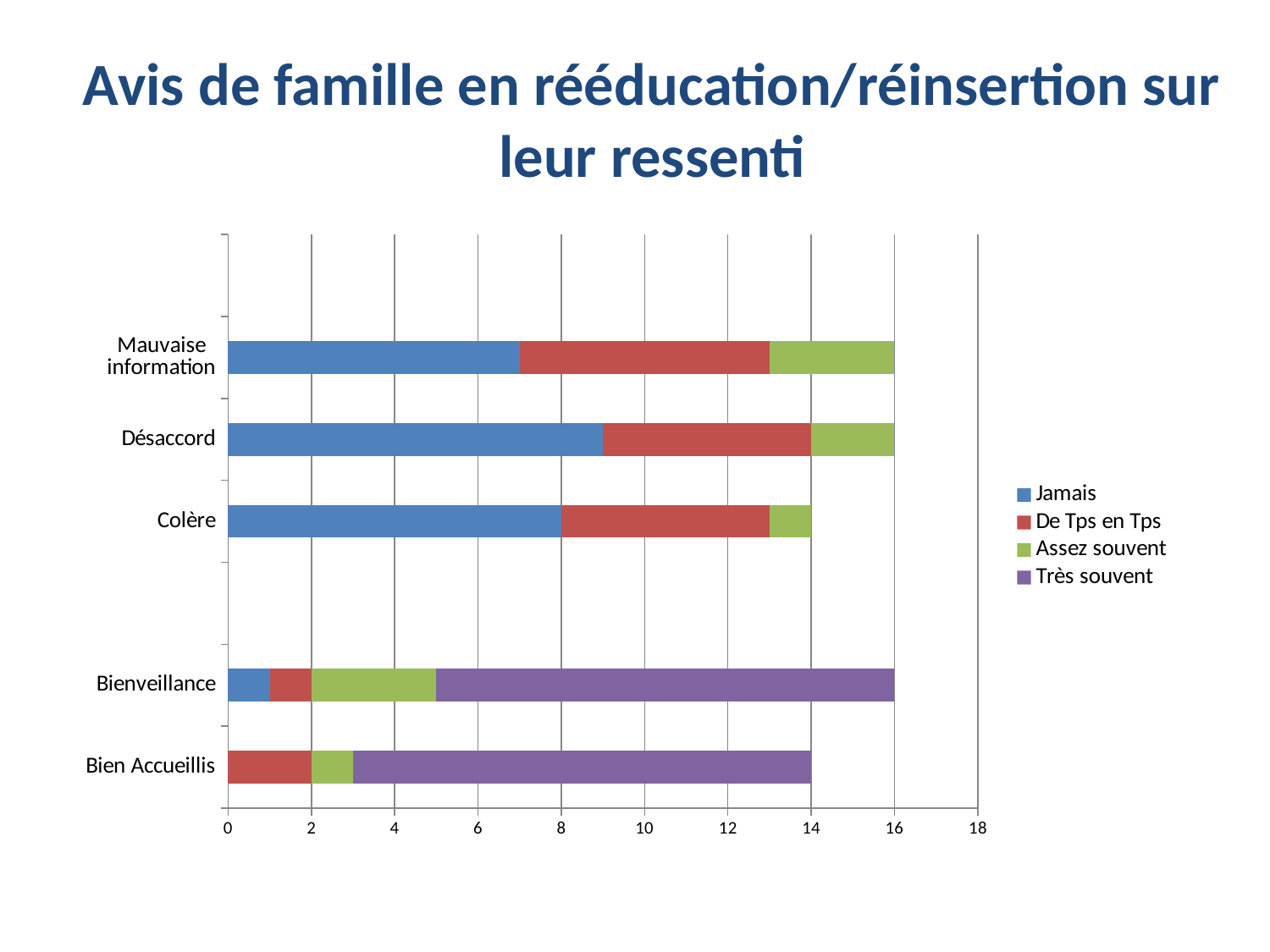
What is the value of De Tps en Tps for Bien Accueillis? 2 What is the value of Jamais for Colère? 8 What is the total length of the stacked bar for Colère? 14 What is the total length of the stacked bar for Bien Accueillis? 14 Is the value of Jamais for Désaccord greater or less than 8? greater What kind of chart is shown on the slide? Stacked bar chart Which legend entry is shown in purple? Très souvent What is the total length of the stacked bar for Bienveillance? 16 Is the value of Jamais for Mauvaise information greater or less than 8? less How many categories are shown on the vertical axis? 5 How many series does the legend list? 4 Which has the longer total stacked bar, Bienveillance or Bien Accueillis? Bienveillance